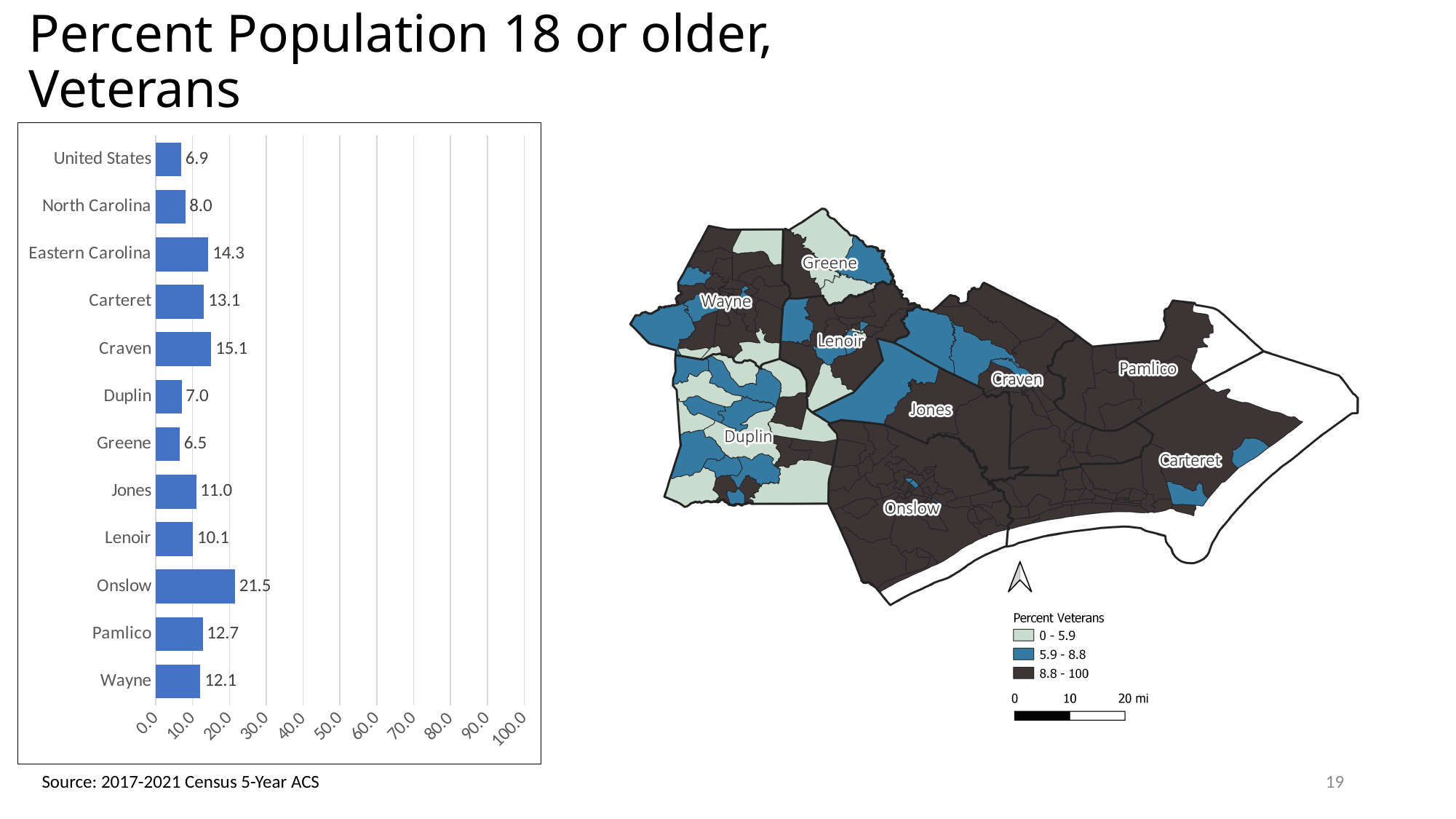
What is the value for Eastern Carolina in the bar chart? 14.3 Which category has the lowest value in the bar chart? Greene Which category has the highest value in the bar chart? Onslow What kind of chart is shown on the left of the slide? bar chart What is the value for Onslow in the bar chart? 21.5 How many categories are shown in the bar chart? 12 What is the value for Greene in the bar chart? 6.5 Is the value for Jones in the bar chart greater or less than 10.0? greater What is the highest value shown on the x axis of the bar chart? 100.0 Which has a larger value in the bar chart, Carteret or Pamlico? Carteret What is the difference between the values for North Carolina and the United States in the bar chart? 1.1 What is the difference between the values for Onslow and Craven in the bar chart? 6.4